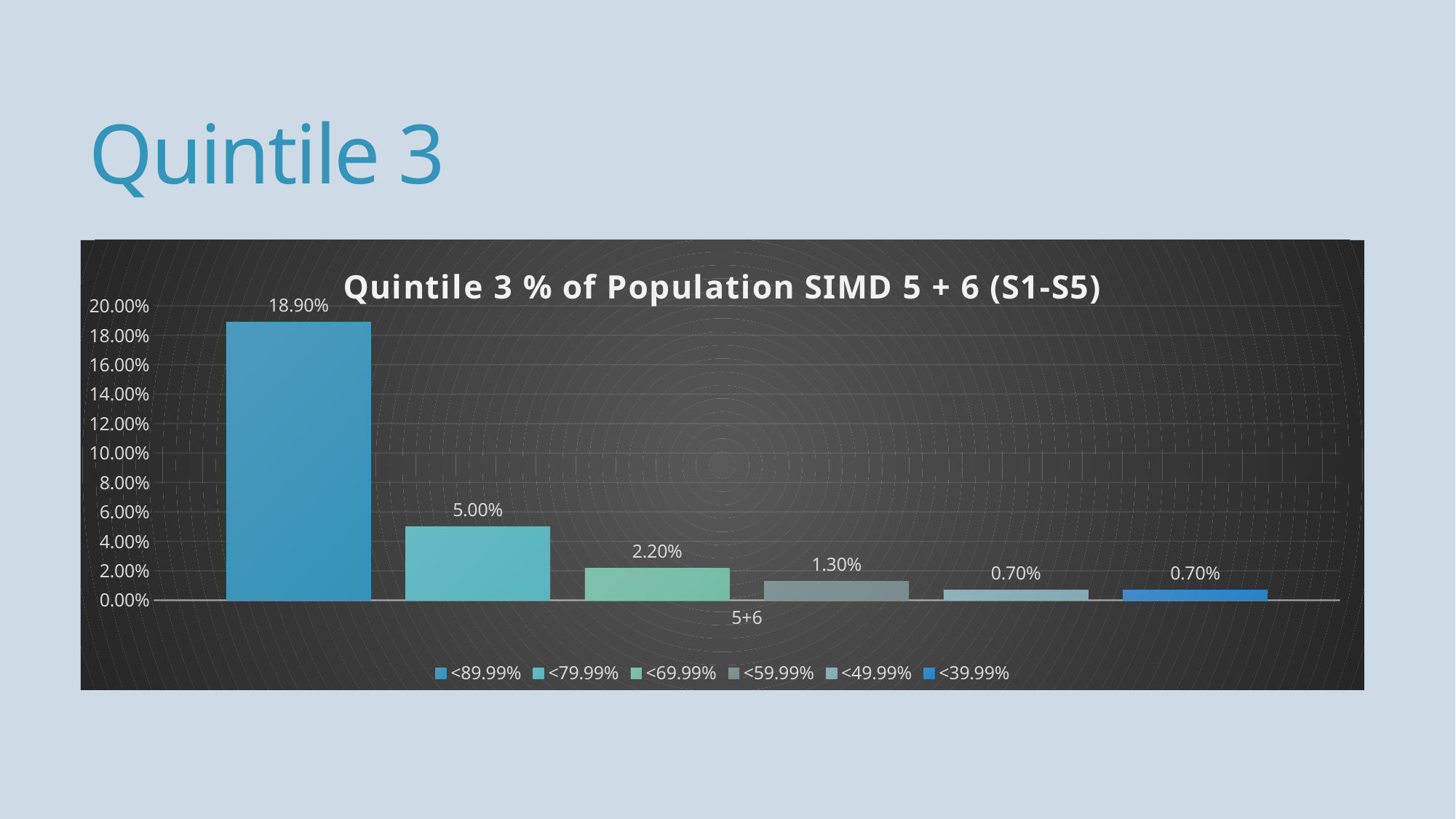
Which series has the highest value? <89.99% What is the difference between the <79.99% and <69.99% values? 2.80% What kind of chart is shown? bar chart What is the value for the <69.99% series? 2.20% What is the value for the <89.99% series? 18.90% What is the difference between the <89.99% and <79.99% values? 13.90% What is the value for the <79.99% series? 5.00% Is the value for <89.99% greater or less than 16.00%? greater How many series does the legend list? 6 What is the value for the <59.99% series? 1.30% Which is larger, the value for <69.99% or the value for <59.99%? <69.99% What is the title of the chart? Quintile 3 % of Population SIMD 5 + 6 (S1-S5)